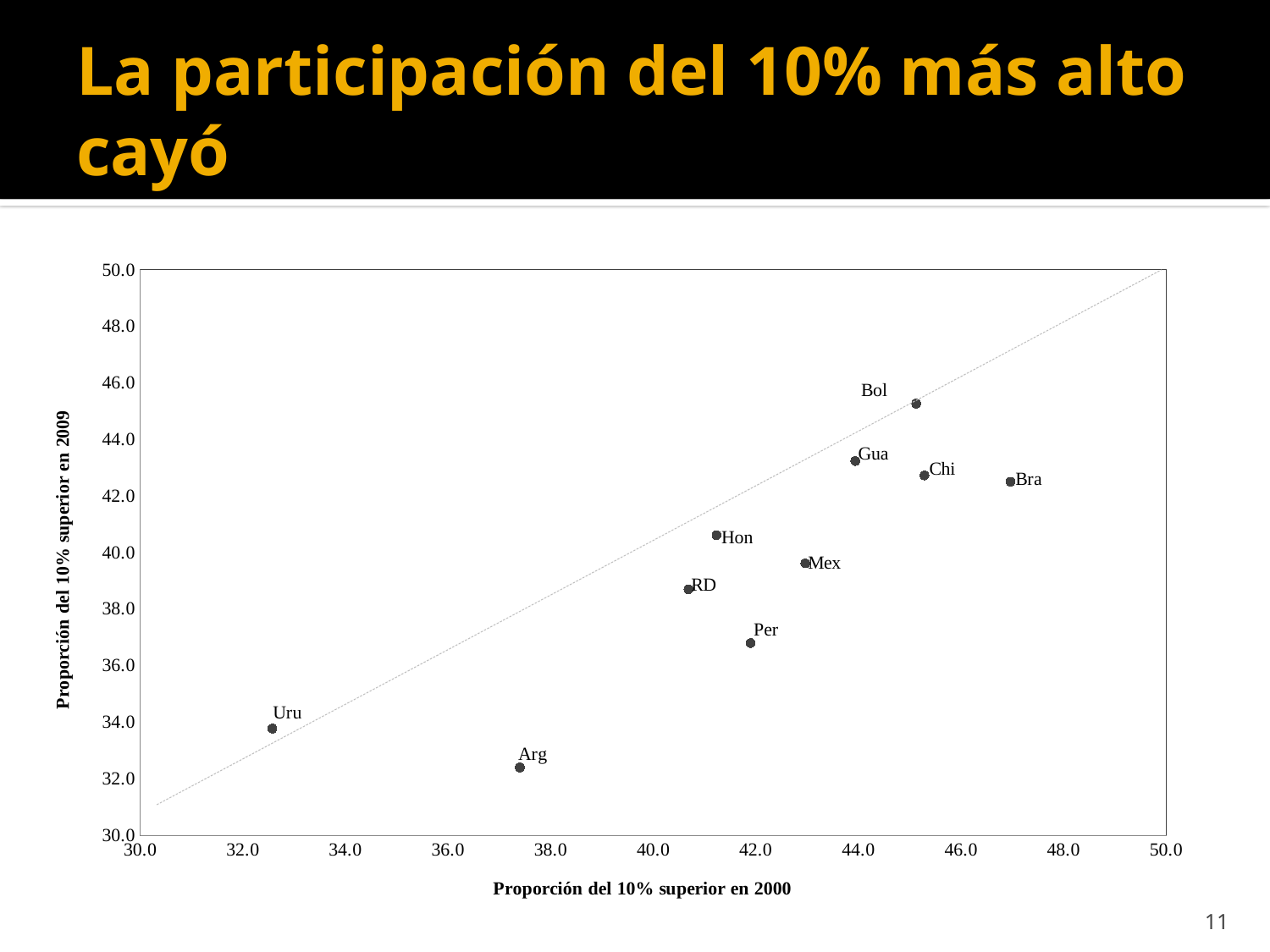
Which country has the lowest value on the vertical axis (Proporción del 10% superior en 2009)? Arg What is the title of the slide? La participación del 10% más alto cayó Is the 2009 value (vertical axis) for Per greater or less than 38.0? less Which country has the lowest value on the horizontal axis (Proporción del 10% superior en 2000)? Uru What is the label of the horizontal axis? Proporción del 10% superior en 2000 Which country has the highest value on the horizontal axis (Proporción del 10% superior en 2000)? Bra What kind of chart is shown on the slide? Scatter plot Is the 2000 value (horizontal axis) for Bra greater or less than 46.0? greater Which country has the highest value on the vertical axis (Proporción del 10% superior en 2009)? Bol How many countries are plotted on the chart? 10 Is the 2009 value (vertical axis) for Bol greater or less than 44.0? greater Which country has a higher 2009 value (vertical axis), Gua or Mex? Gua